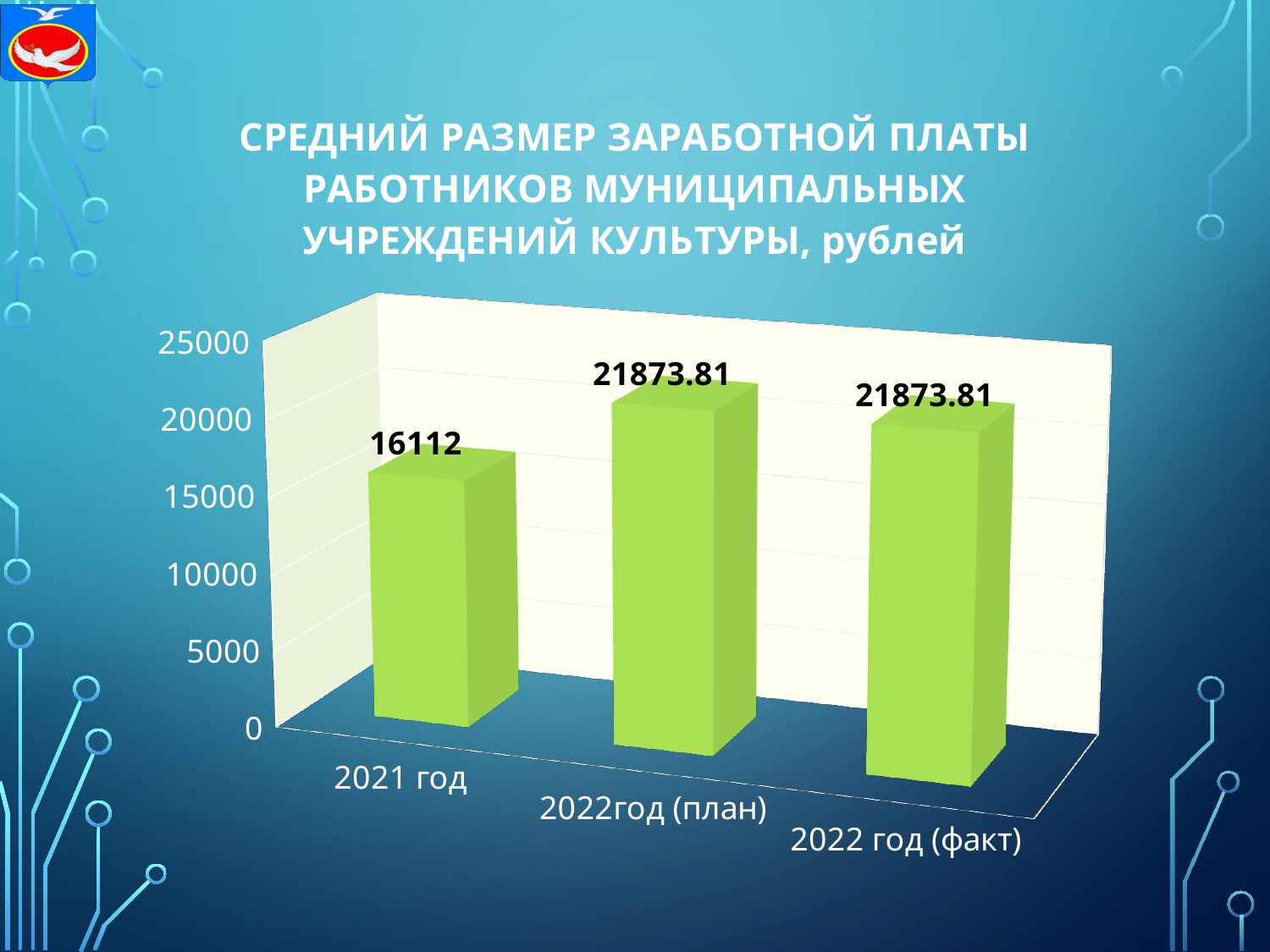
How many categories are shown on the x axis? 3 What is the value for 2022год (план)? 21873.81 What is the difference between the value for 2022год (план) and the value for 2021 год? 5761.81 What is the value for 2021 год? 16112 Is the value for 2022 год (факт) greater or less than 20000? greater Is the value for 2021 год greater or less than 15000? greater Which category has the lowest value? 2021 год Which is larger, the value for 2021 год or the value for 2022 год (факт)? 2022 год (факт) What is the difference between the value for 2022 год (факт) and the value for 2022год (план)? 0 What is the value for 2022 год (факт)? 21873.81 Does the value rise or fall from 2021 год to 2022год (план)? rise What kind of chart is shown on the slide? bar chart